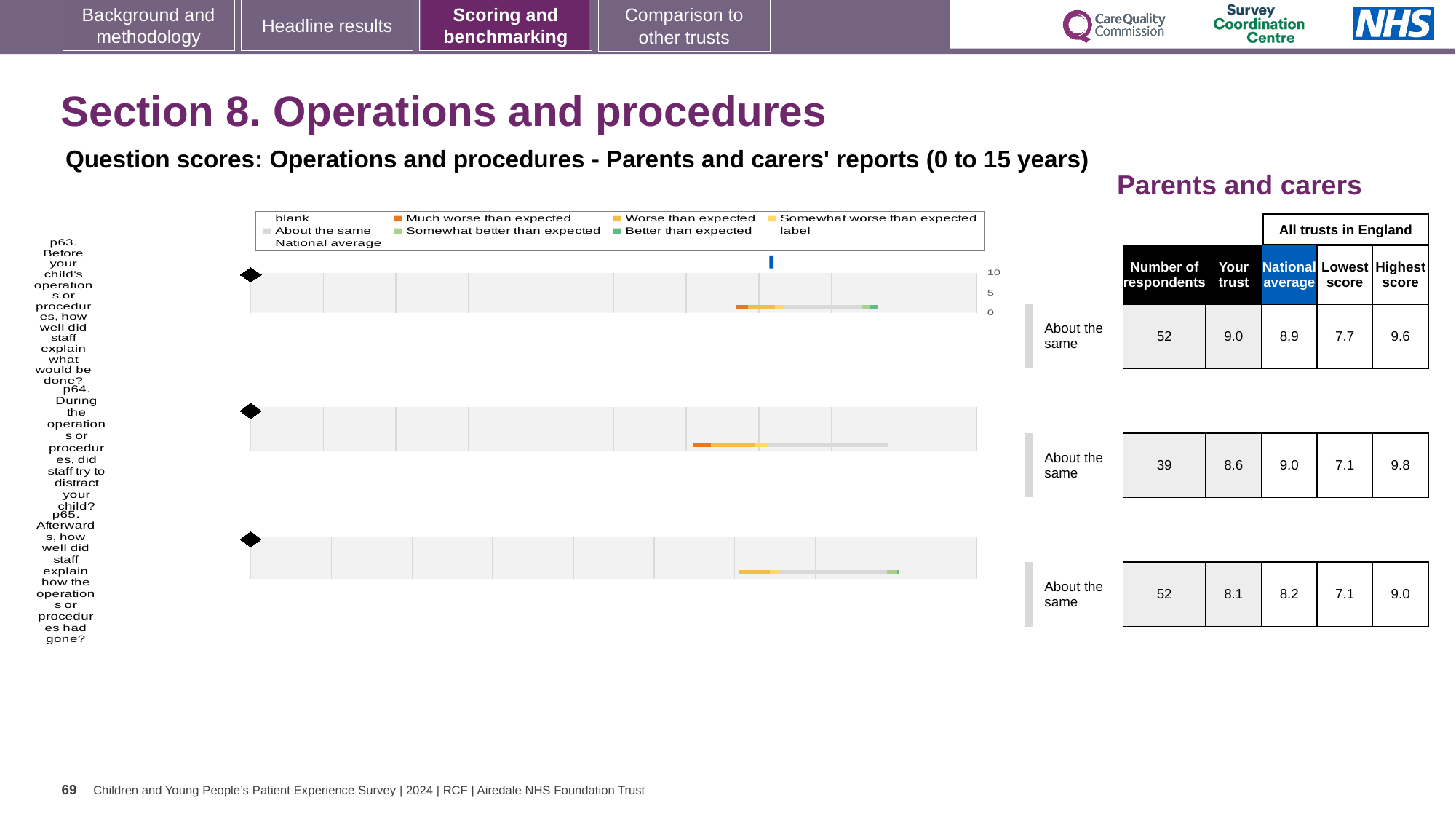
What is the difference between the highest score (9.8) and the lowest score (7.1) for question p64? 2.7 How many respondents answered question p64 (did staff try to distract your child)? 39 Which legend entry is shown in blue? National average Which question has the lowest 'Your trust' score? p65 What is the highest score among all trusts in England for question p64? 9.8 For question p63, which is larger: the 'Your trust' score or the national average? Your trust Which question has the highest 'Your trust' score? p63 What is the 'Your trust' score for question p63 (how well staff explained what would be done)? 9.0 What is the national average score for question p65 (how well staff explained how the operation had gone)? 8.2 What colour represents 'Much worse than expected' in the legend? orange What kind of chart is used to show the question scores on this slide? bar chart How many questions (p63, p64, p65) are plotted as bars on the slide? 3